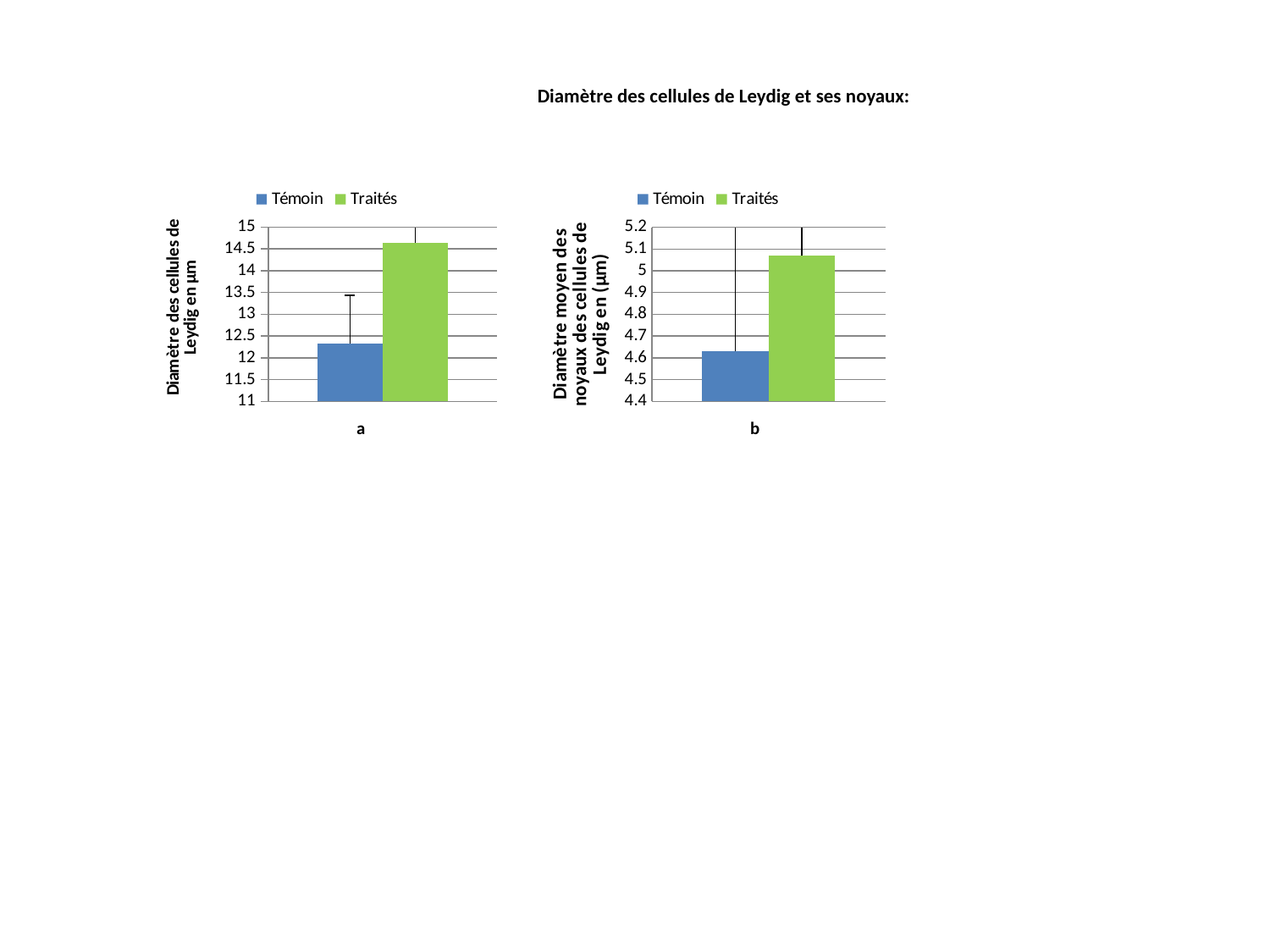
In chart b (the right chart), which series has the shorter bar, Témoin or Traités? Témoin How many series does the legend of chart b (the right chart) list? 2 In chart b (the right chart), is the value for Traités greater or less than 5? greater What is the y-axis title of chart a (the left chart)? Diamètre des cellules de Leydig en µm In chart b (the right chart), what is the highest value shown on the y axis? 5.2 What are the two series named in the legend of chart a (the left chart)? Témoin and Traités What kind of chart is chart a (the left chart)? bar chart In chart a (the left chart), is the value for Témoin greater or less than 13? less In chart b (the right chart), is the value for Témoin greater or less than 4.8? less In chart a (the left chart), which series has the taller bar, Témoin or Traités? Traités